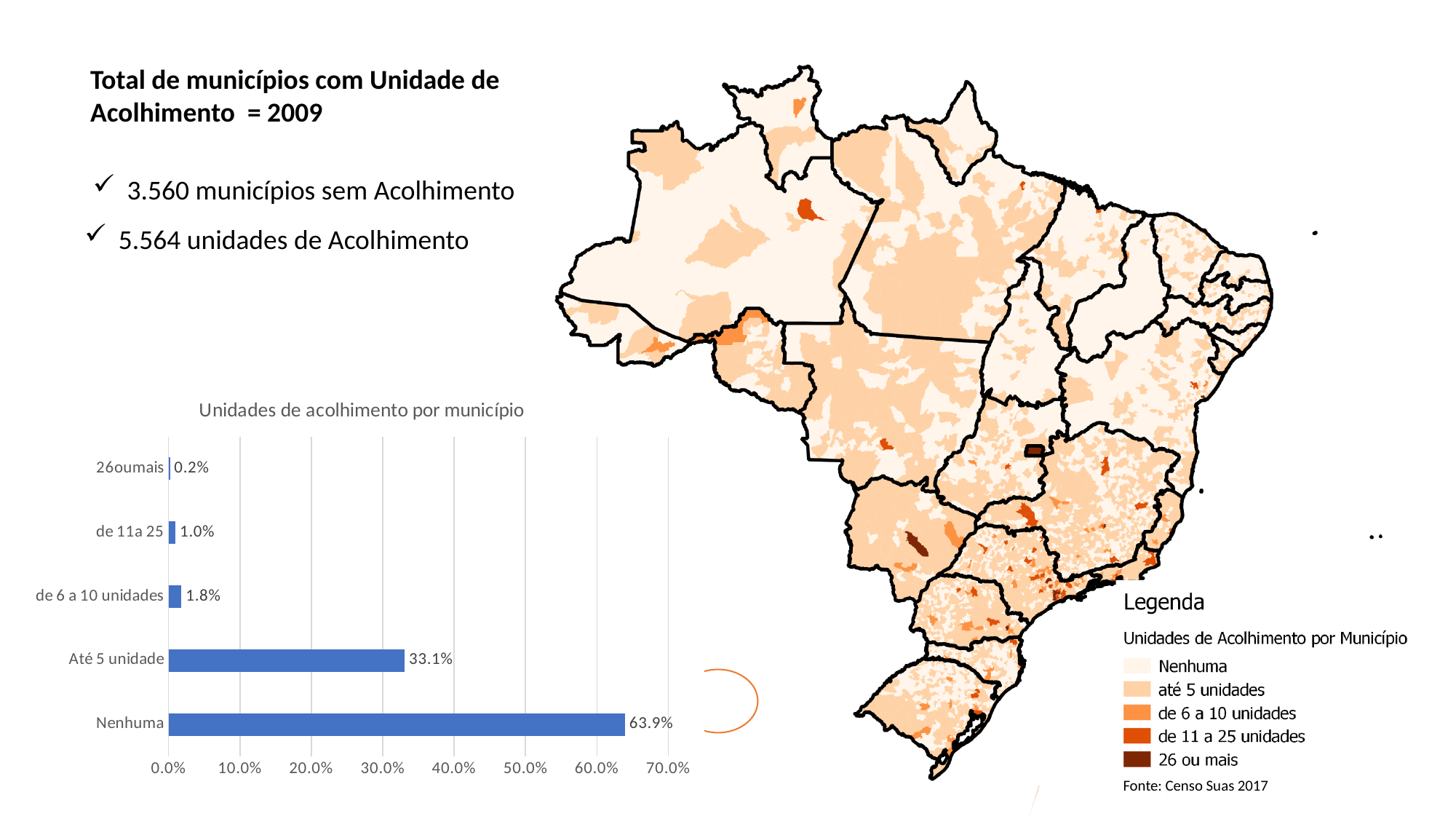
How many categories are shown in the chart "Unidades de acolhimento por município"? 5 What kind of chart is "Unidades de acolhimento por município"? bar chart What is the value for "Até 5 unidade" in the bar chart? 33.1% Which category has the lowest value in the bar chart? 26oumais What is the value for "de 11a 25" in the bar chart? 1.0% What is the value for "Nenhuma" in the chart "Unidades de acolhimento por município"? 63.9% Which category has the highest value in the chart "Unidades de acolhimento por município"? Nenhuma Is the value for "Nenhuma" in the bar chart greater or less than 60.0%? greater In the bar chart, which is larger: the value for "de 6 a 10 unidades" or the value for "de 11a 25"? de 6 a 10 unidades What is the difference between the values for "Nenhuma" and "Até 5 unidade" in the bar chart? 30.8% What is the value for "26oumais" in the bar chart? 0.2% What is the value for "de 6 a 10 unidades" in the bar chart? 1.8%